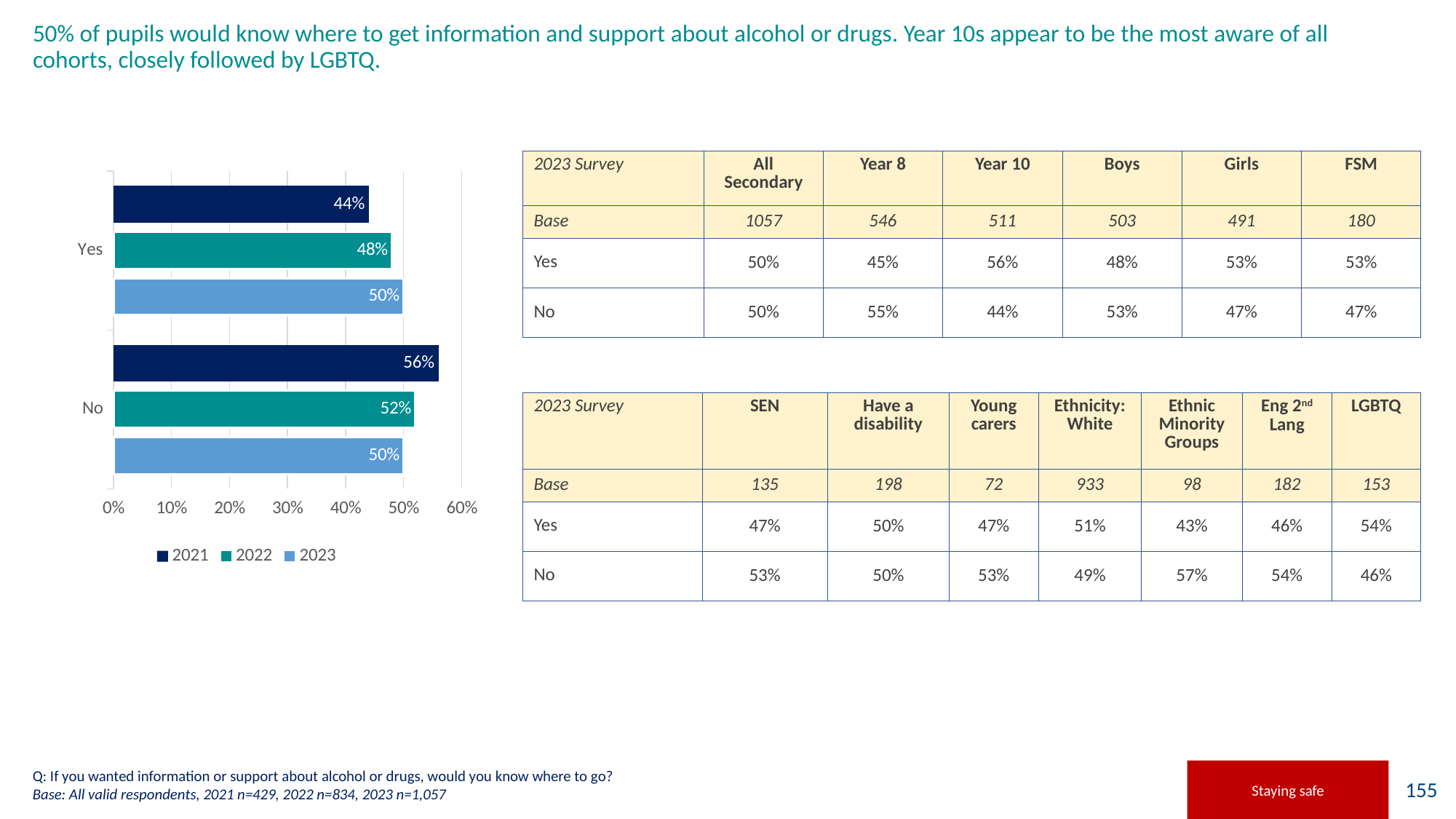
Which year has the highest value for No? 2021 Which year has the lowest value for Yes? 2021 What is the value for Yes in 2021? 44% What kind of chart is shown on the slide? bar chart Is the value for No in 2021 greater or less than 50%? greater What is the value for Yes in 2023? 50% How many categories are shown on the chart's vertical axis? 2 Which is larger: the Yes value in 2022 or the No value in 2022? No in 2022 How many series does the chart legend list? 3 What is the difference between the No value in 2021 and the Yes value in 2021? 12% Which series is shown in the darkest blue colour in the chart? 2021 What is the value for No in 2022? 52%